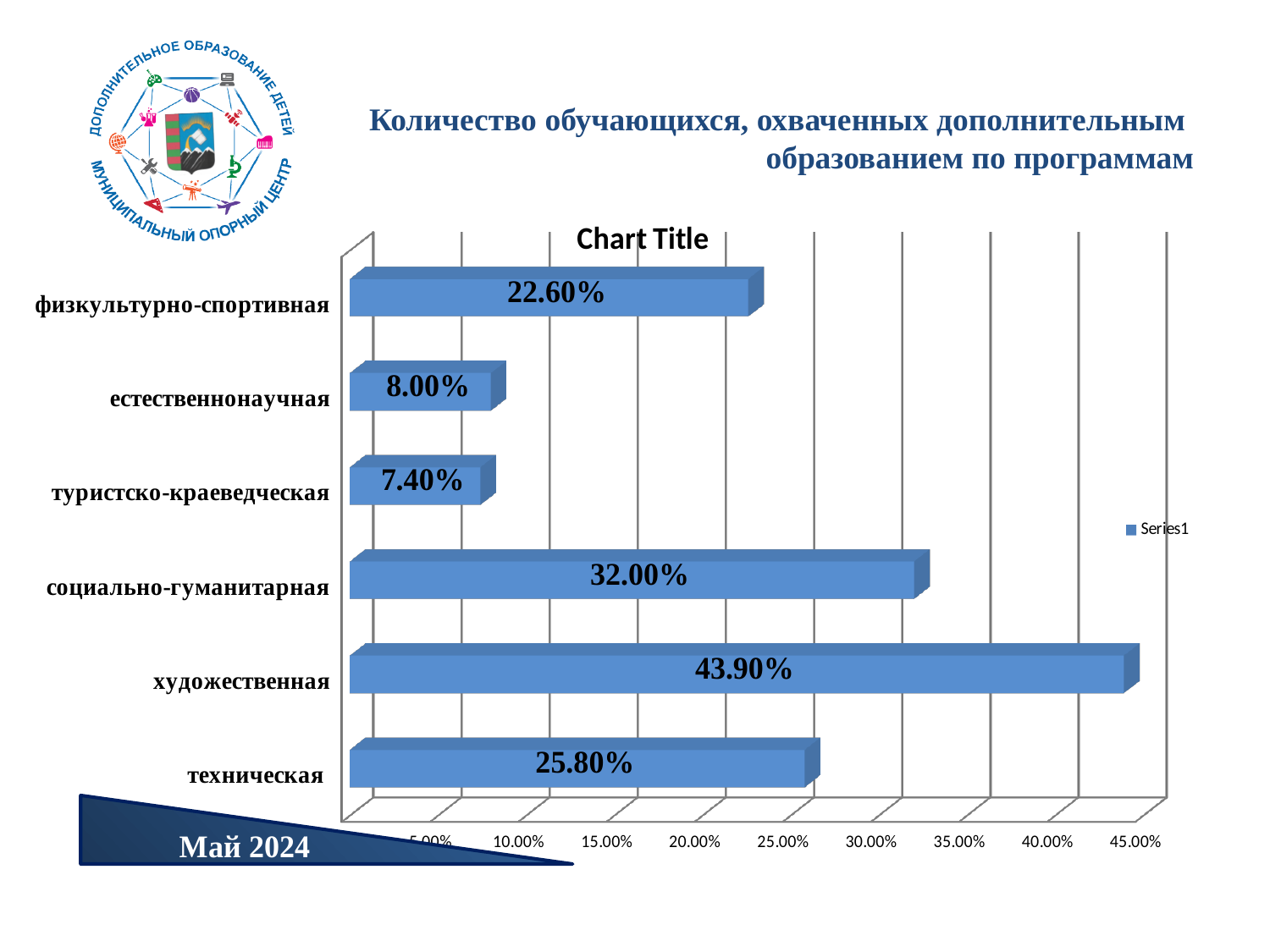
Which is larger, the value for техническая or the value for физкультурно-спортивная? техническая Which category has the lowest value? туристско-краеведческая What is the name of the series shown in the legend? Series1 What is the value for художественная? 43.90% What is the value for техническая? 25.80% Is the value for социально-гуманитарная greater or less than 30.00%? greater What is the difference between the values for социально-гуманитарная and физкультурно-спортивная? 9.40% What is the value for естественнонаучная? 8.00% How many series does the legend list? 1 Which category has the highest value? художественная How many categories are shown in the chart? 6 What kind of chart is shown on the slide? bar chart